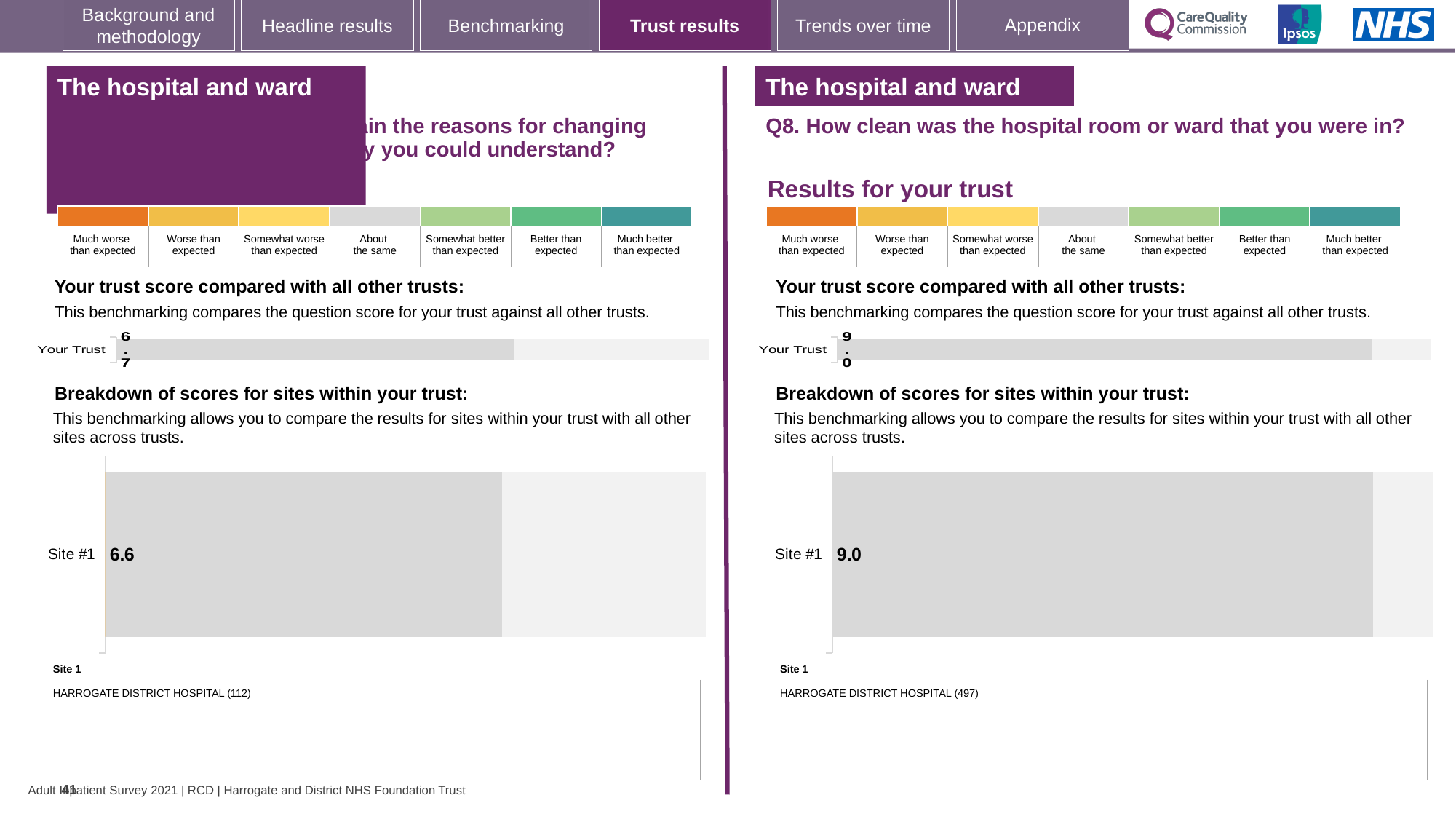
What kind of chart is used to show the Site #1 score on the left-hand side of the slide? Bar chart Which site is listed as Site 1 below the breakdown chart on the left-hand side of the slide? HARROGATE DISTRICT HOSPITAL (112) On the left-hand side of the slide, what is the difference between the Your Trust score and the Site #1 score? 0.1 Which is larger: the Your Trust score on the left-hand side of the slide or the Your Trust score on the right-hand side (Q8)? The right-hand side (Q8) How many sites are shown in the breakdown of scores for sites within your trust on the right-hand side of the slide (Q8)? 1 On the right-hand side of the slide (Q8), is the Site #1 score the same as the Your Trust score? Yes On the right-hand side of the slide (Q8, how clean was the hospital room or ward), what is the score shown for Your Trust? 9.0 On the left-hand side of the slide, what score is shown for Site #1 in the breakdown of scores for sites within your trust? 6.6 On the left-hand side of the slide, what is the score shown for Your Trust in the trust score comparison chart? 6.7 Which site is listed as Site 1 below the breakdown chart on the right-hand side of the slide (Q8)? HARROGATE DISTRICT HOSPITAL (497) On the right-hand side of the slide (Q8), what score is shown for Site #1 in the breakdown of scores for sites within your trust? 9.0 What is the difference between the Your Trust score for Q8 on the right-hand side and the Your Trust score on the left-hand side of the slide? 2.3